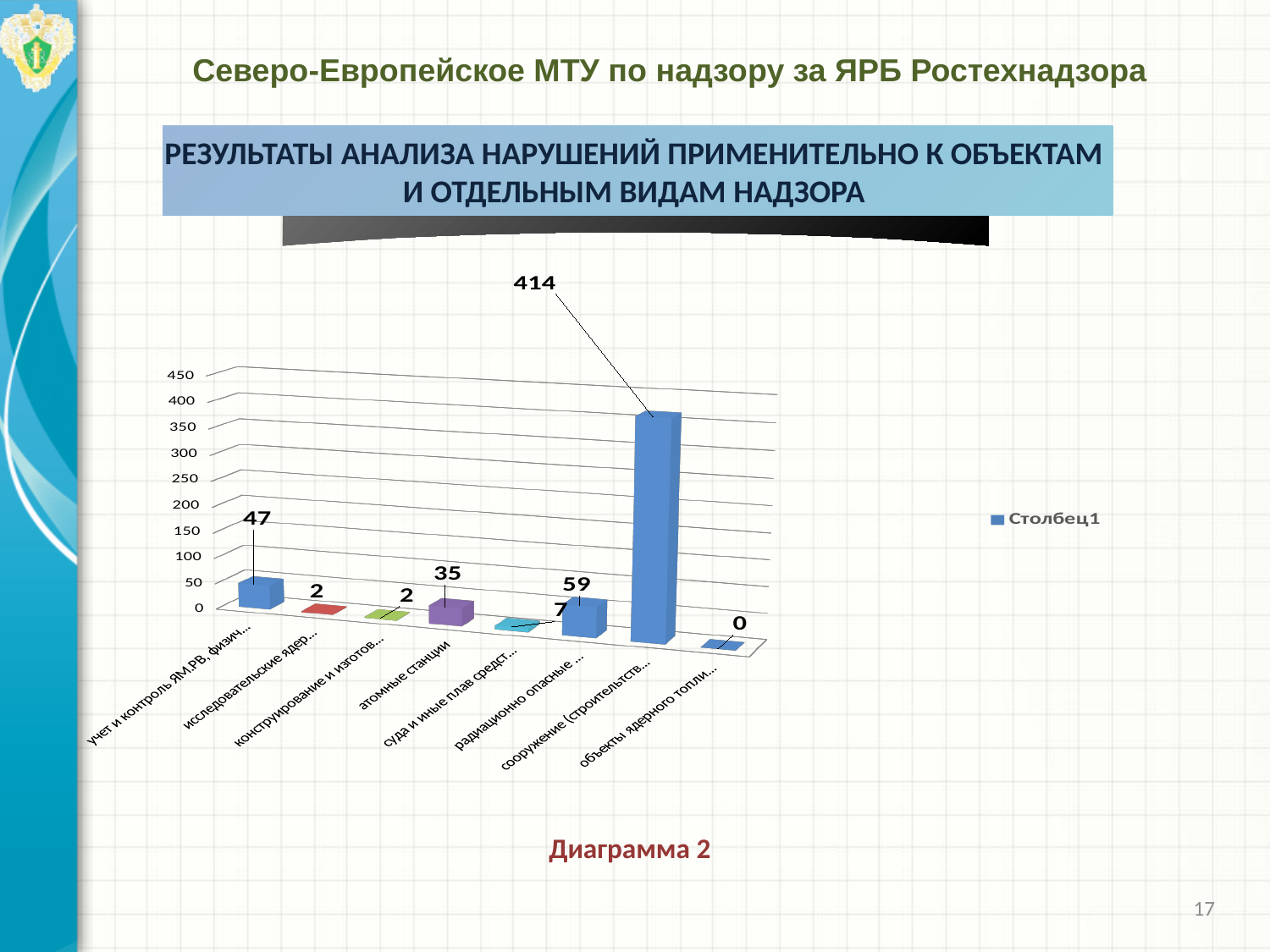
What is the difference between the value for радиационно опасные ... (59) and the value for атомные станции (35)? 24 What is the value of the tallest bar in the chart? 414 How many series does the legend list? 1 What is the value for атомные станции? 35 Which is larger: the value for атомные станции or the value for учет и контроль ЯМ,РВ, физич...? учет и контроль ЯМ,РВ, физич... What kind of chart is shown on the slide? bar chart What is the value for радиационно опасные ...? 59 Which category has the highest value? сооружение (строительств...) What is the value of the last (rightmost) bar, объекты ядерного топли...? 0 What is the value of the first (leftmost) bar, учет и контроль ЯМ,РВ, физич...? 47 What is the name of the series shown in the legend? Столбец1 How many categories are shown on the x axis of the chart? 8